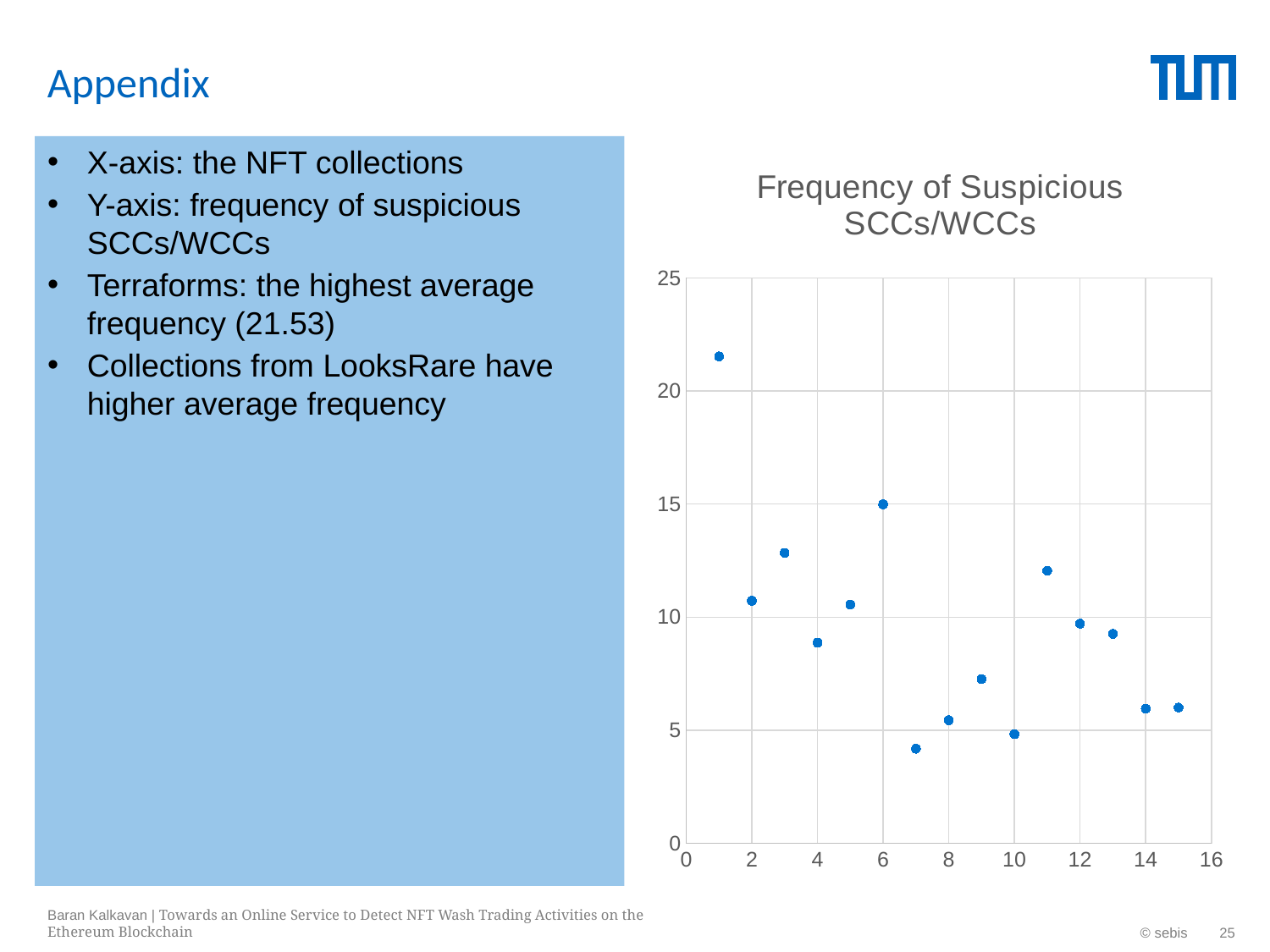
Is the value of the point at x = 14 greater or less than 5? greater Is the value of the point at x = 11 greater or less than 10? greater Which point has the larger value, the one at x = 6 or the one at x = 11? x = 6 Which point has the larger value, the one at x = 2 or the one at x = 3? x = 3 Is the value of the point at x = 7 greater or less than 5? less What is the title of the chart? Frequency of Suspicious SCCs/WCCs What kind of chart is shown on the slide? scatter chart How many data points are plotted in the chart? 15 What is the highest value shown on the y axis? 25 At which x value is the highest point plotted? 1